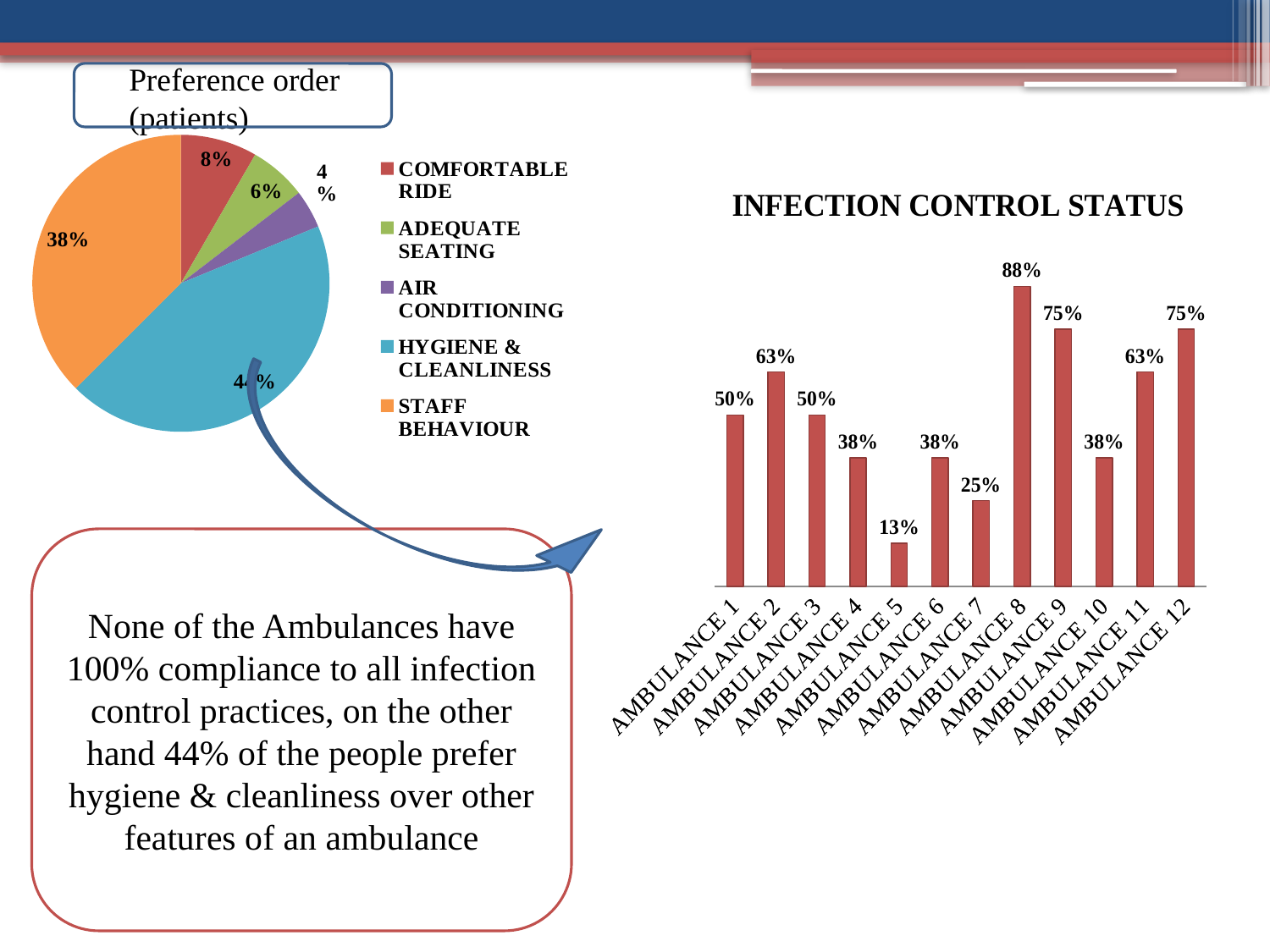
In the Preference order (patients) pie chart, what share is COMFORTABLE RIDE? 8% In the INFECTION CONTROL STATUS chart, which ambulance has the lowest value? AMBULANCE 5 What kind of chart is the INFECTION CONTROL STATUS chart? Bar chart How many categories does the legend of the Preference order (patients) pie chart list? 5 In the Preference order (patients) pie chart, what share is STAFF BEHAVIOUR? 38% How many ambulances are shown in the INFECTION CONTROL STATUS chart? 12 In the INFECTION CONTROL STATUS chart, which ambulance has the highest value? AMBULANCE 8 In the Preference order (patients) pie chart, which category has the smallest share? AIR CONDITIONING In the INFECTION CONTROL STATUS chart, what is the value for AMBULANCE 8? 88% In the INFECTION CONTROL STATUS chart, what is the difference between the values for AMBULANCE 8 and AMBULANCE 7? 63% In the INFECTION CONTROL STATUS chart, what is the value for AMBULANCE 5? 13% In the INFECTION CONTROL STATUS chart, which is larger, the value for AMBULANCE 2 or AMBULANCE 4? AMBULANCE 2